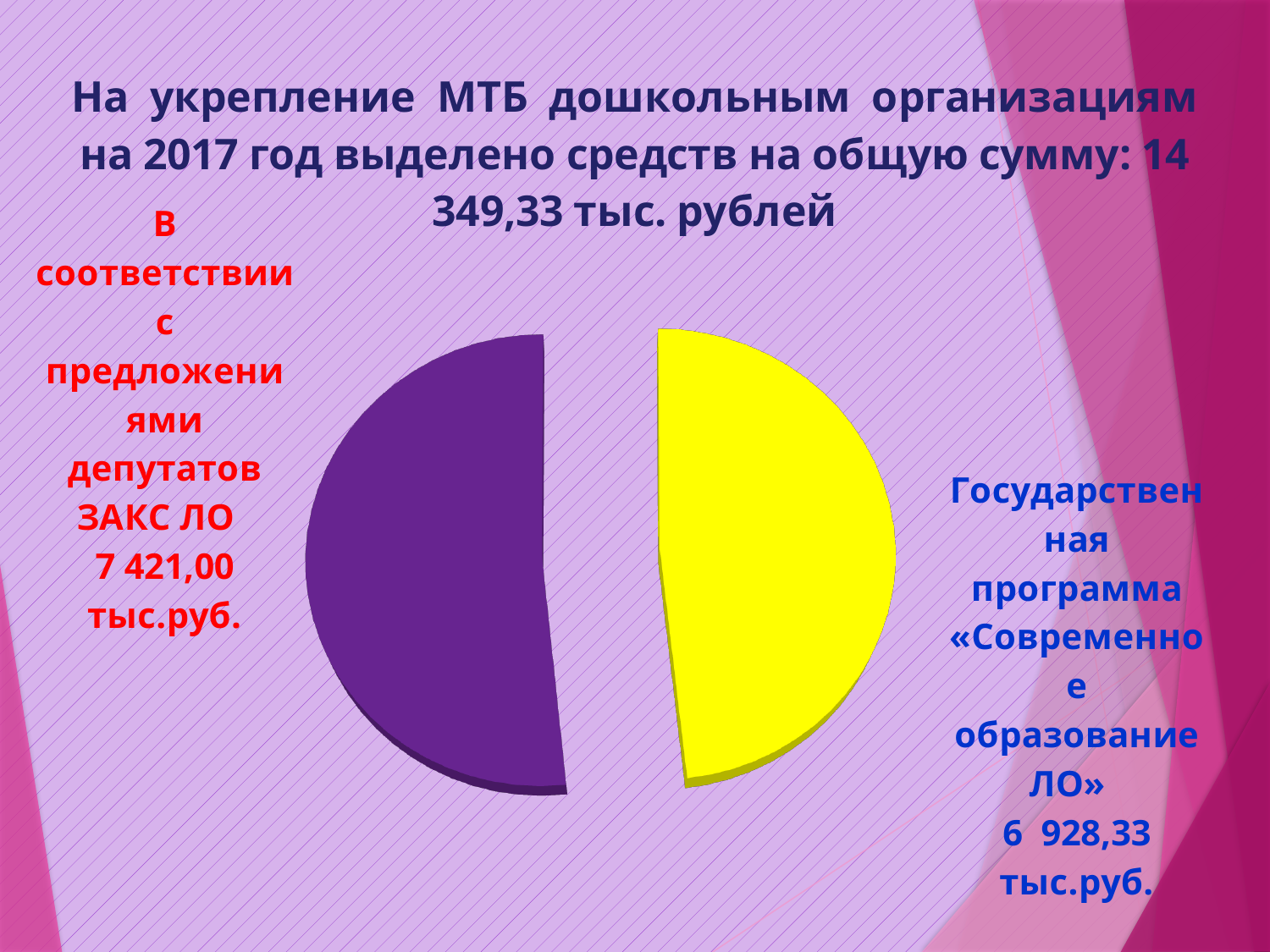
Which colour is the slice for the Государственная программа «Современное образование ЛО»? yellow Which colour is the slice for «В соответствии с предложениями депутатов ЗАКС ЛО»? purple What kind of chart is shown on the slide? pie chart Which slice of the pie represents the smaller amount? Государственная программа «Современное образование ЛО» What amount is shown for the Государственная программа «Современное образование ЛО»? 6 928,33 тыс.руб. How many slices does the pie chart have? 2 Which slice of the pie represents the larger amount? В соответствии с предложениями депутатов ЗАКС ЛО What is the total amount of funds allocated in 2017 according to the slide title? 14 349,33 тыс. рублей Which is larger: the funds under the deputies' proposals (ЗАКС ЛО) or the funds under the state program «Современное образование ЛО»? В соответствии с предложениями депутатов ЗАКС ЛО What is the difference between the deputies' proposals amount (7 421,00) and the state program amount (6 928,33), in тыс.руб.? 492,67 What amount is shown for «В соответствии с предложениями депутатов ЗАКС ЛО»? 7 421,00 тыс.руб.